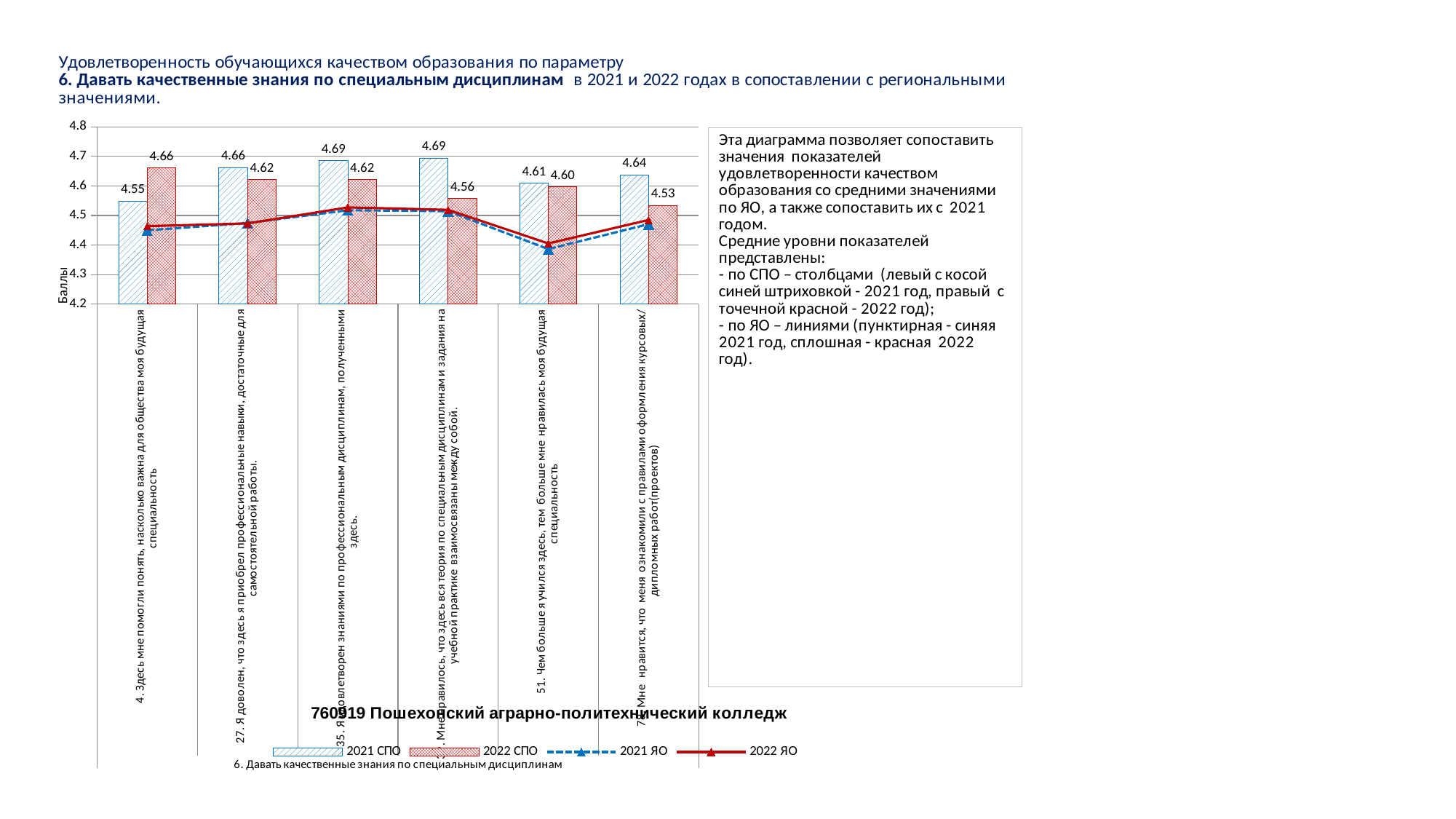
Which category has the lowest 2021 СПО value? 4. Здесь мне помогли понять, насколько важна для общества моя будущая специальность Is the 2022 ЯО line value for the category '51. Чем больше я учился здесь, тем больше мне нравилась моя будущая специальность' greater or less than 4.5? less What is the 2021 СПО value for the category '27. Я доволен, что здесь я приобрел профессиональные навыки, достаточные для самостоятельной работы'? 4.66 For the category '35. Я удовлетворен знаниями по профессиональным дисциплинам, полученными здесь', which is larger: the 2021 СПО value or the 2022 СПО value? 2021 СПО What is the label of the vertical axis of the chart? Баллы Which category has the lowest 2022 СПО value? Мне нравится, что меня ознакомили с правилами оформления курсовых/дипломных работ(проектов) What type of chart is shown on the slide? Combined bar and line chart How many series does the chart legend list? 4 How many categories (questions) are plotted along the x axis of the chart? 6 What is the 2022 СПО value for the category '51. Чем больше я учился здесь, тем больше мне нравилась моя будущая специальность'? 4.60 What is the 2022 СПО value for the category '4. Здесь мне помогли понять, насколько важна для общества моя будущая специальность'? 4.66